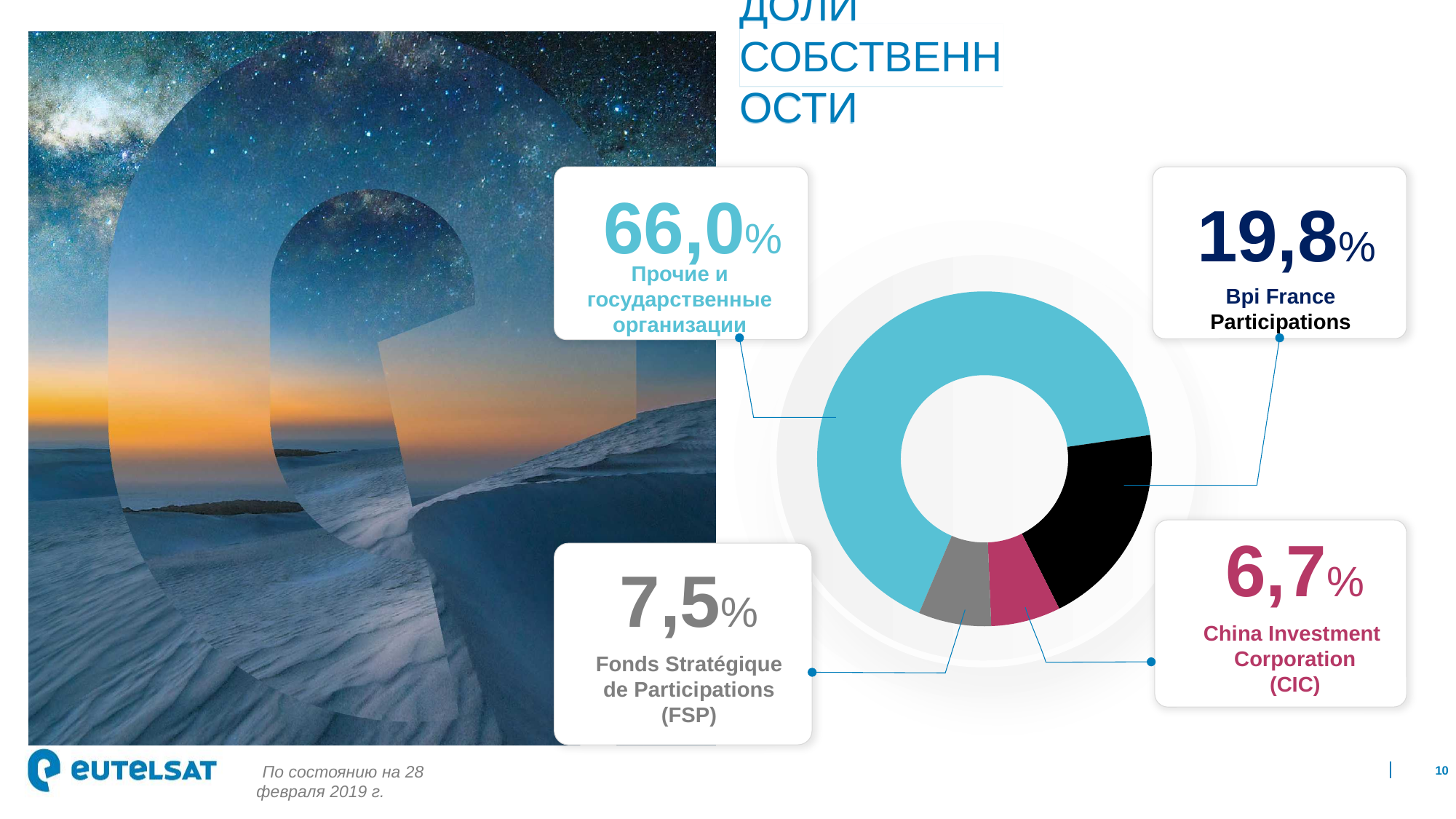
What is the difference between the share of 'Прочие и государственные организации' and the share of Bpi France Participations? 46,2% Which shareholder category has the largest share in the chart? Прочие и государственные организации What share of ownership is held by 'Прочие и государственные организации'? 66,0% What is the difference between the shares of Fonds Stratégique de Participations (FSP) and China Investment Corporation (CIC)? 0,8% What kind of chart is shown on the slide? Doughnut chart Which shareholder has the smallest share in the chart? China Investment Corporation (CIC) How many shareholder categories are shown in the chart? 4 What share of ownership is held by Fonds Stratégique de Participations (FSP)? 7,5% What colour is the slice representing Bpi France Participations? Black What share of ownership is held by Bpi France Participations? 19,8% What share of ownership is held by China Investment Corporation (CIC)? 6,7% Which holds a larger share: Fonds Stratégique de Participations (FSP) or China Investment Corporation (CIC)? Fonds Stratégique de Participations (FSP)